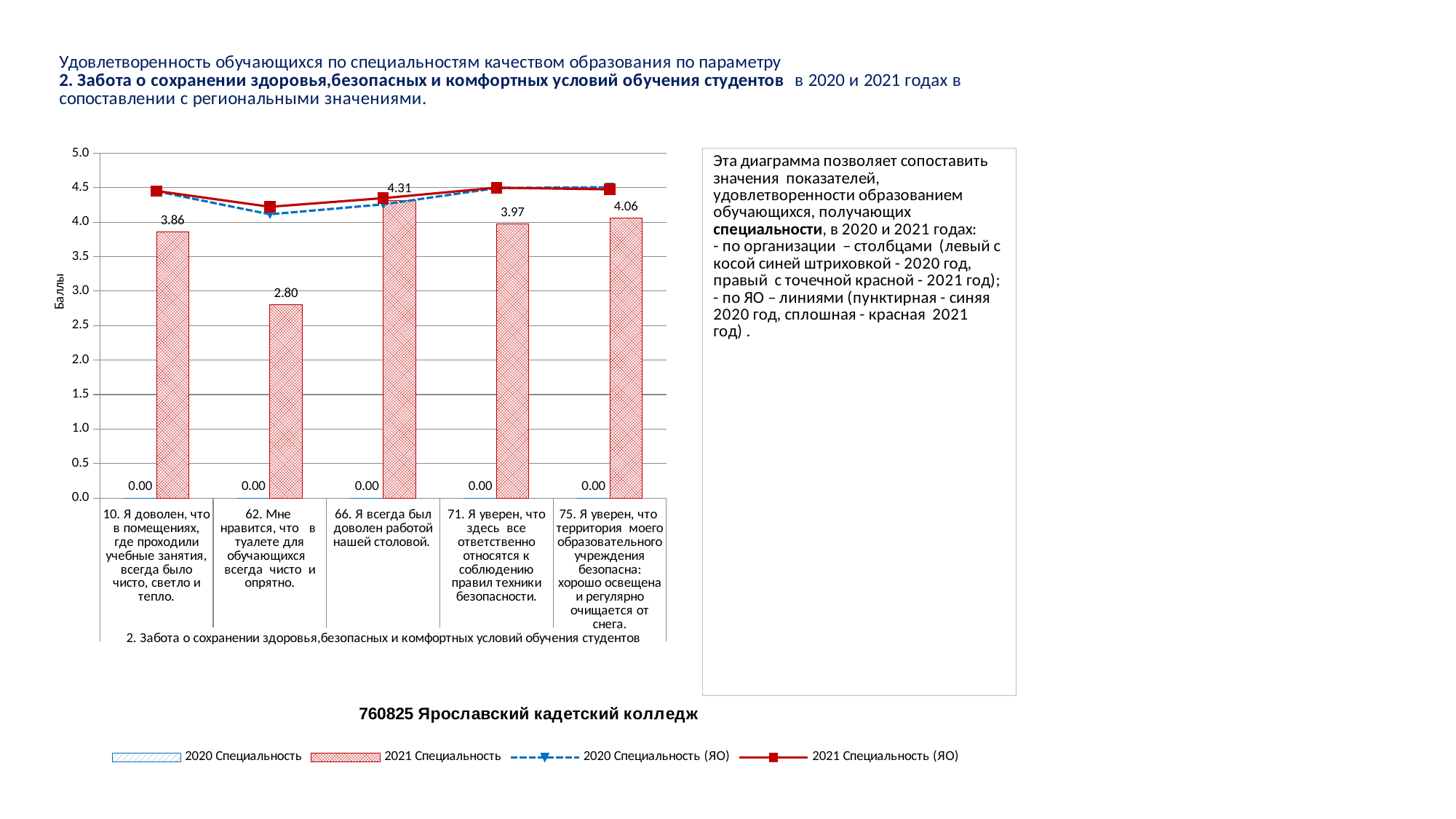
How many series does the legend list? 4 How many questions (categories) are shown on the x axis? 5 What is the 2021 Специальность value for question 66 (Я всегда был доволен работой нашей столовой)? 4.31 Which has the larger 2021 Специальность value: question 71 or question 75? 75. Я уверен, что территория моего образовательного учреждения безопасна What kind of chart is shown on the slide? Combined bar and line chart What is the 2020 Специальность value for question 10 (Я доволен, что в помещениях, где проходили учебные занятия, всегда было чисто, светло и тепло)? 0.00 What is the difference between the 2021 Специальность values for question 66 and question 62? 1.51 Is the 2021 Специальность (ЯО) line value for question 62 greater or less than 4.0? greater Which question has the lowest 2021 Специальность bar? 62. Мне нравится, что в туалете для обучающихся всегда чисто и опрятно. What is the 2021 Специальность value for question 62 (Мне нравится, что в туалете для обучающихся всегда чисто и опрятно)? 2.80 Which question has the highest 2021 Специальность bar? 66. Я всегда был доволен работой нашей столовой. What is the label of the vertical axis? Баллы